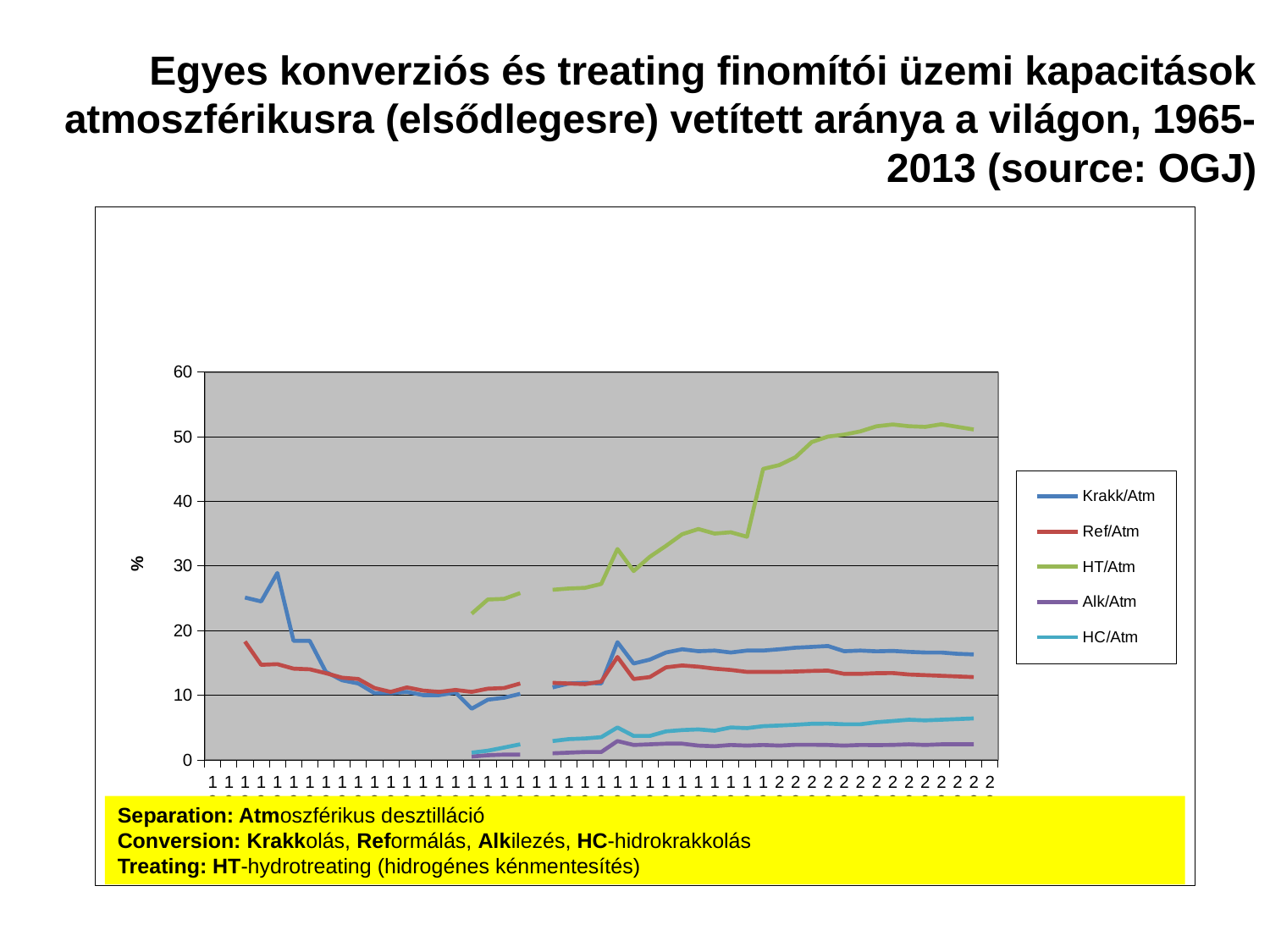
At the right end of the chart, which is larger: Krakk/Atm or Ref/Atm? Krakk/Atm Is the Alk/Atm series greater or less than 10 throughout the chart? less How many series does the legend list? 5 Which series has the lowest values on the chart? Alk/Atm Which series reaches the highest value on the chart? HT/Atm Is the highest value of the Krakk/Atm series greater or less than 20? greater Is the final value of the HT/Atm series greater or less than 50? greater What is the label on the vertical axis? % At the right end of the chart, which is larger: HC/Atm or Alk/Atm? HC/Atm Does the HT/Atm series rise or fall along the x axis overall? rises What kind of chart is shown on the slide? line chart